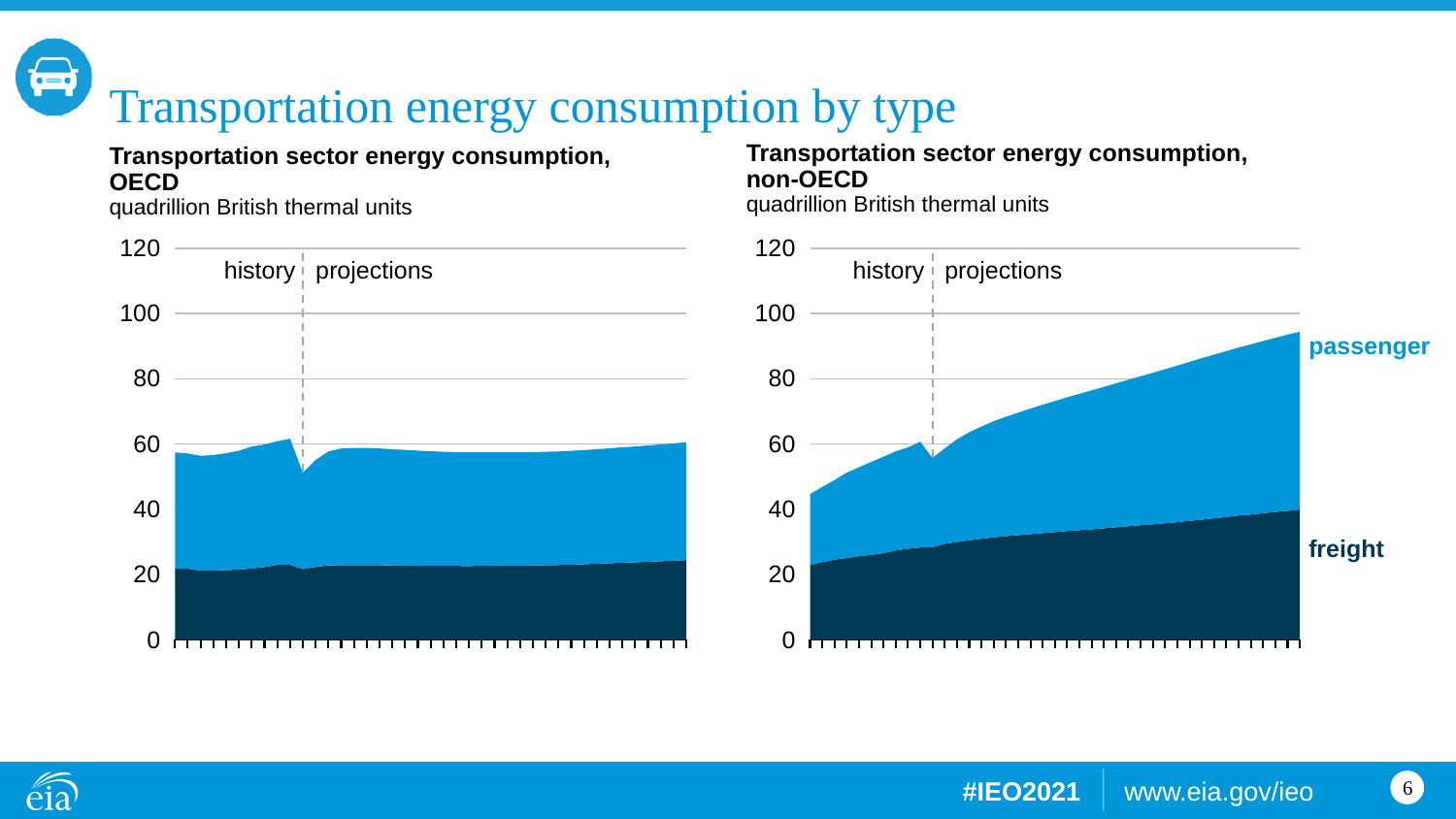
In the 'Transportation sector energy consumption, non-OECD' chart, what are the two series labelled? passenger and freight At the end of the projection period, which chart shows higher total transportation energy consumption: OECD or non-OECD? non-OECD How many series are shown in the 'Transportation sector energy consumption, non-OECD' chart? 2 In the 'Transportation sector energy consumption, non-OECD' chart, is the total consumption at the end of the projection period greater or less than 80? greater What unit is used on the y axis of both charts? quadrillion British thermal units What kind of chart is the 'Transportation sector energy consumption, OECD' chart? stacked area chart In the 'Transportation sector energy consumption, OECD' chart, is freight consumption at the end of the projection period greater or less than 40? less In the 'Transportation sector energy consumption, OECD' chart, is the total consumption at the end of the projection period greater or less than 80? less In the 'Transportation sector energy consumption, non-OECD' chart, does total transportation energy consumption rise or fall over the projection period? rise In the 'Transportation sector energy consumption, non-OECD' chart, does freight consumption rise or fall over the projection period? rise